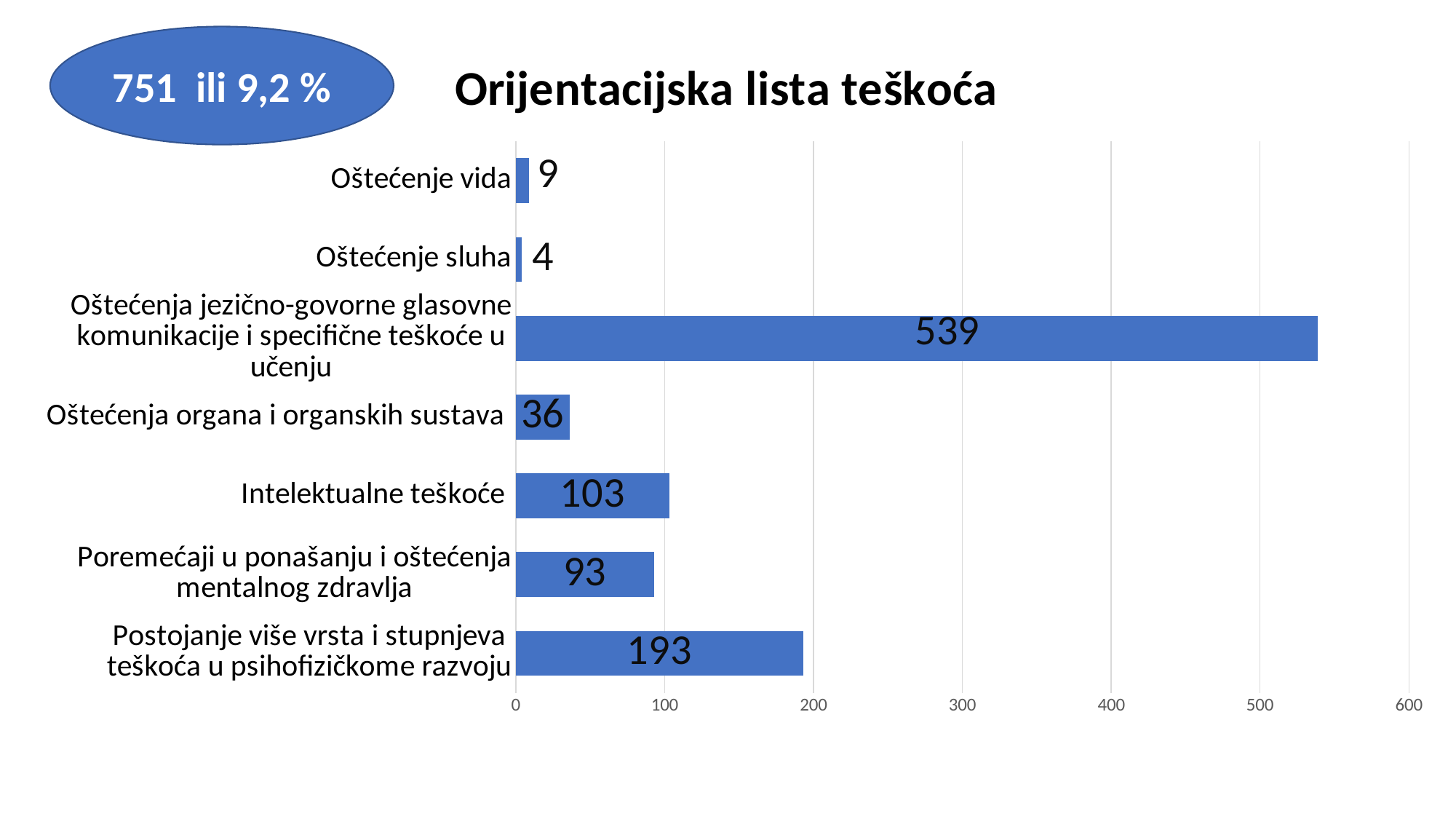
What is the value for Postojanje više vrsta i stupnjeva teškoća u psihofizičkome razvoju? 193 What is the difference between the values for Intelektualne teškoće and Poremećaji u ponašanju i oštećenja mentalnog zdravlja? 10 What is the value for Oštećenja organa i organskih sustava? 36 What is the value for Oštećenje vida? 9 Which category has the highest value? Oštećenja jezično-govorne glasovne komunikacije i specifične teškoće u učenju Which category has the lowest value? Oštećenje sluha Which is larger, the value for Oštećenje vida or the value for Oštećenje sluha? Oštećenje vida What kind of chart is shown on the slide? Bar chart What is the title of the chart? Orijentacijska lista teškoća What is the value for Intelektualne teškoće? 103 How many categories are shown in the chart? 7 What is the difference between the values for Postojanje više vrsta i stupnjeva teškoća u psihofizičkome razvoju and Oštećenja organa i organskih sustava? 157